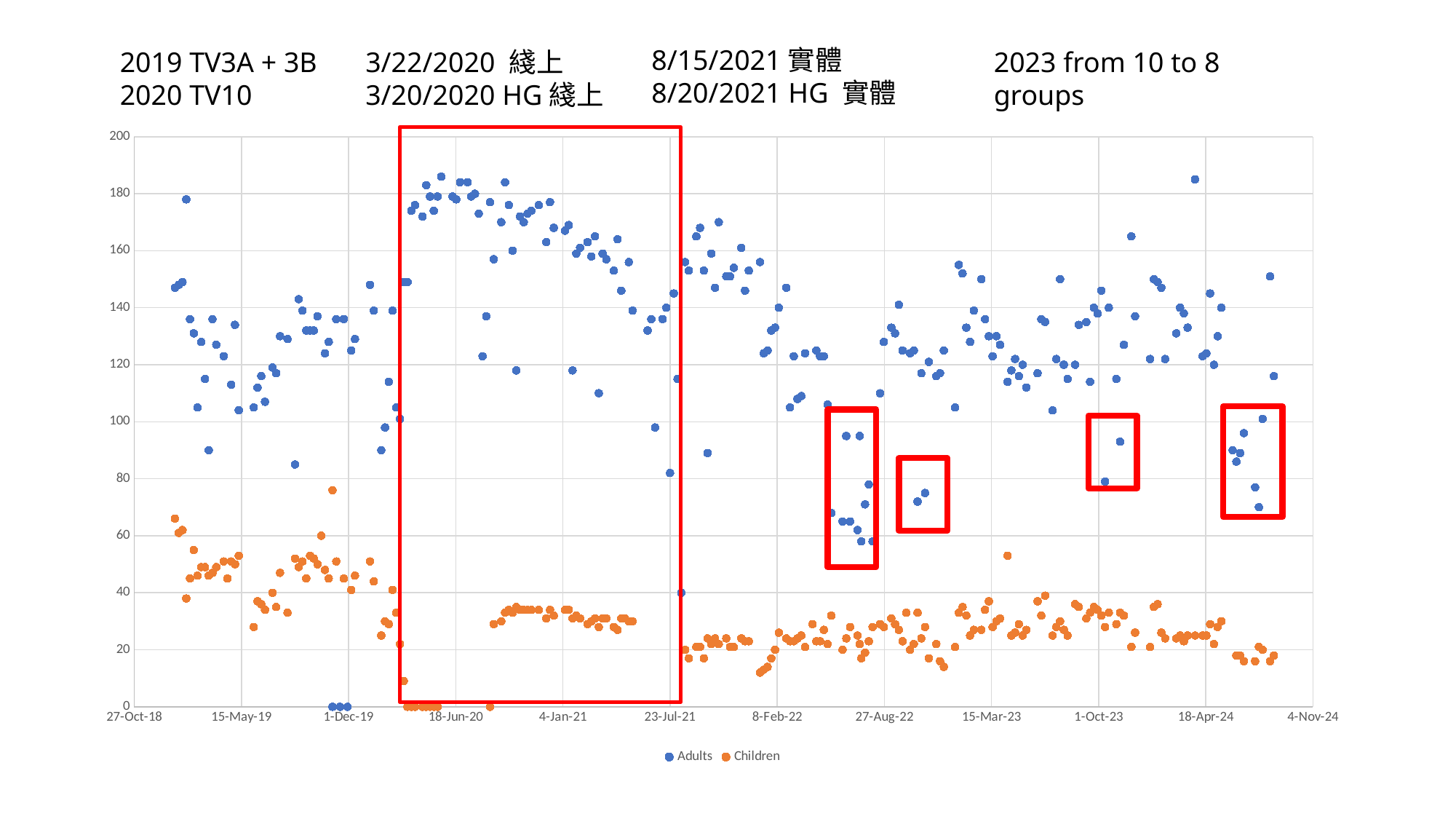
How many series does the legend list? 2 Do the Adults values rise or fall between 18-Jun-20 and 23-Jul-21? fall Are the Children values around 15-Mar-23 greater or less than 60? less Are the Children values around 18-Jun-20 greater or less than 20? less Are the Adults values around 18-Jun-20 greater or less than 160? greater Which series generally has the higher values, Adults or Children? Adults Around 4-Jan-21, which series has the larger values, Adults or Children? Adults What is the highest value shown on the vertical axis? 200 What are the two series named in the legend? Adults and Children Which colour represents the Children series? orange What kind of chart is shown on the slide? scatter chart